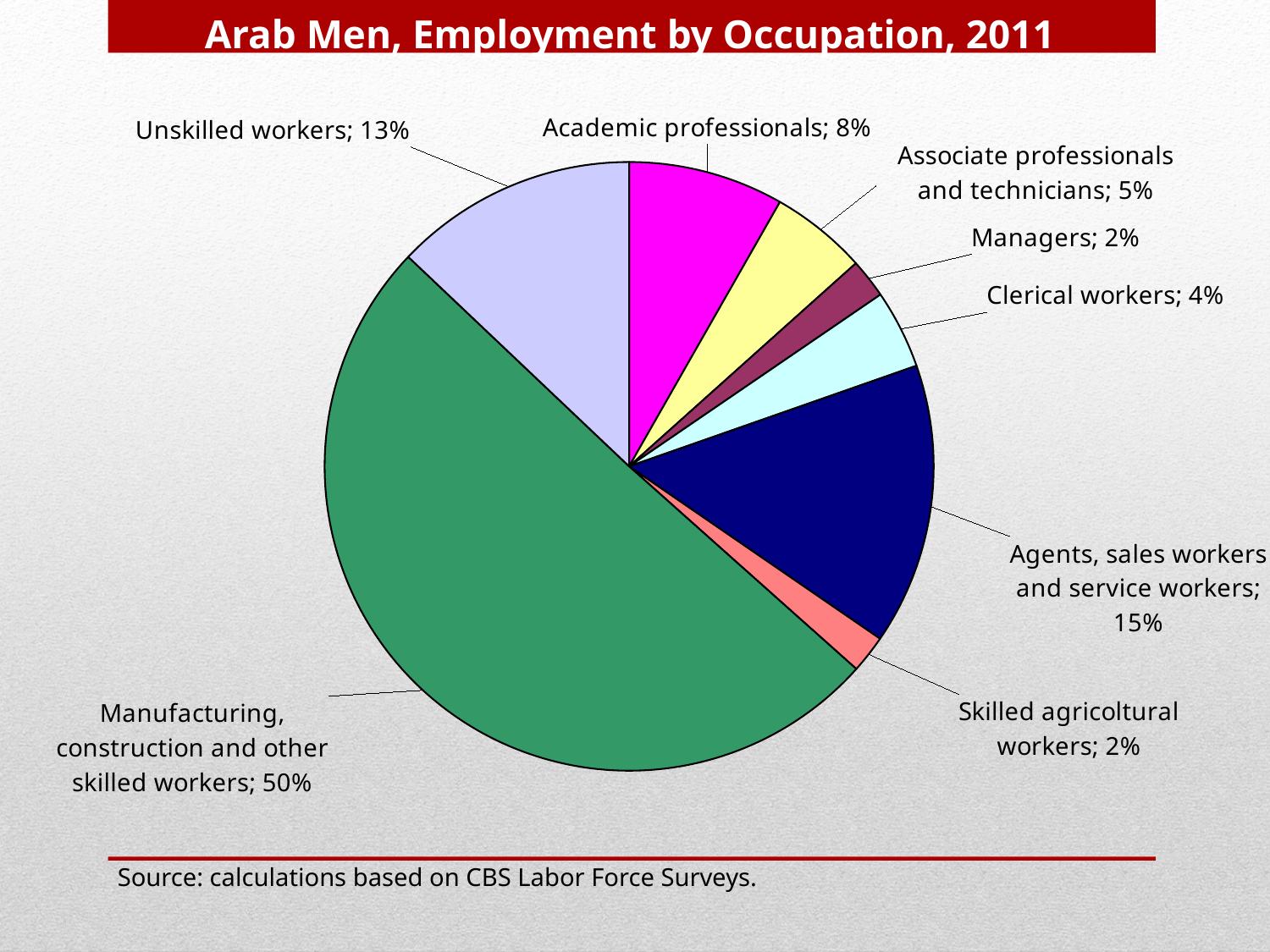
What share of Arab men's employment is in manufacturing, construction and other skilled workers? 50% Which is larger, the share for associate professionals and technicians or the share for clerical workers? Associate professionals and technicians What percentage is shown for clerical workers? 4% What is the title of the chart? Arab Men, Employment by Occupation, 2011 What is the combined share of managers and skilled agricoltural workers? 4% Which occupation category has the largest share of the pie? Manufacturing, construction and other skilled workers What is the difference in percentage points between unskilled workers and academic professionals? 5 What percentage is shown for academic professionals? 8% What percentage is shown for unskilled workers? 13% What type of chart is shown on the slide? Pie chart What percentage is shown for agents, sales workers and service workers? 15% How many occupation categories are shown in the pie chart? 8